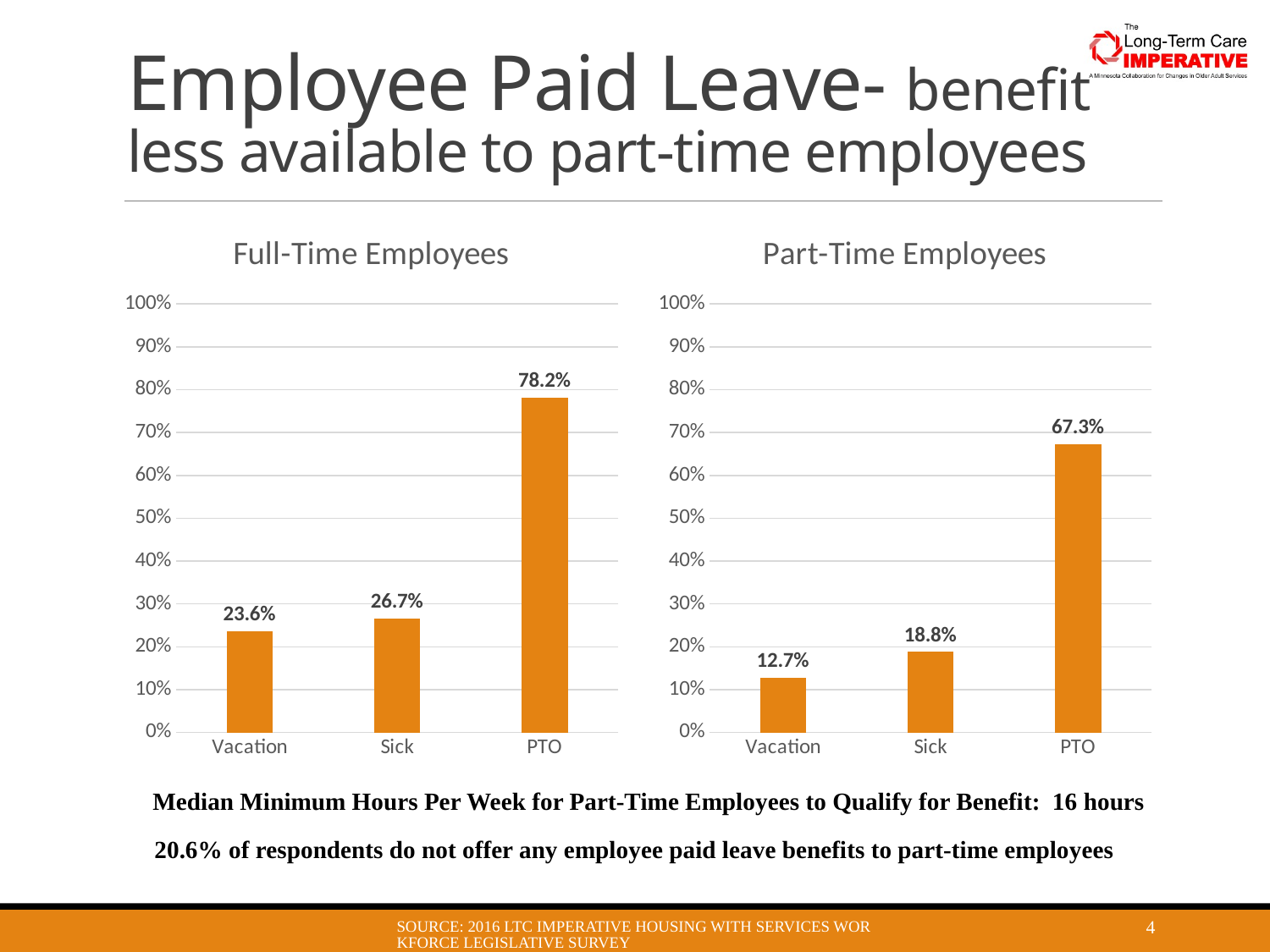
In the Part-Time Employees chart, what is the value for Vacation? 12.7% What is the title of the chart on the left side of the slide? Full-Time Employees What kind of chart is the Part-Time Employees chart? bar chart Which is larger: the Sick value in the Full-Time Employees chart or the Sick value in the Part-Time Employees chart? Full-Time Employees How many categories are shown in the Full-Time Employees chart? 3 What is the difference between the PTO value in the Full-Time Employees chart and the PTO value in the Part-Time Employees chart? 10.9% In the Part-Time Employees chart, which category has the lowest value? Vacation In the Part-Time Employees chart, is the value for PTO greater or less than 60%? greater In the Full-Time Employees chart, what is the difference between the Sick and Vacation values? 3.1% In the Part-Time Employees chart, what is the value for Sick? 18.8% In the Full-Time Employees chart, what is the value for PTO? 78.2% In the Full-Time Employees chart, which category has the highest value? PTO